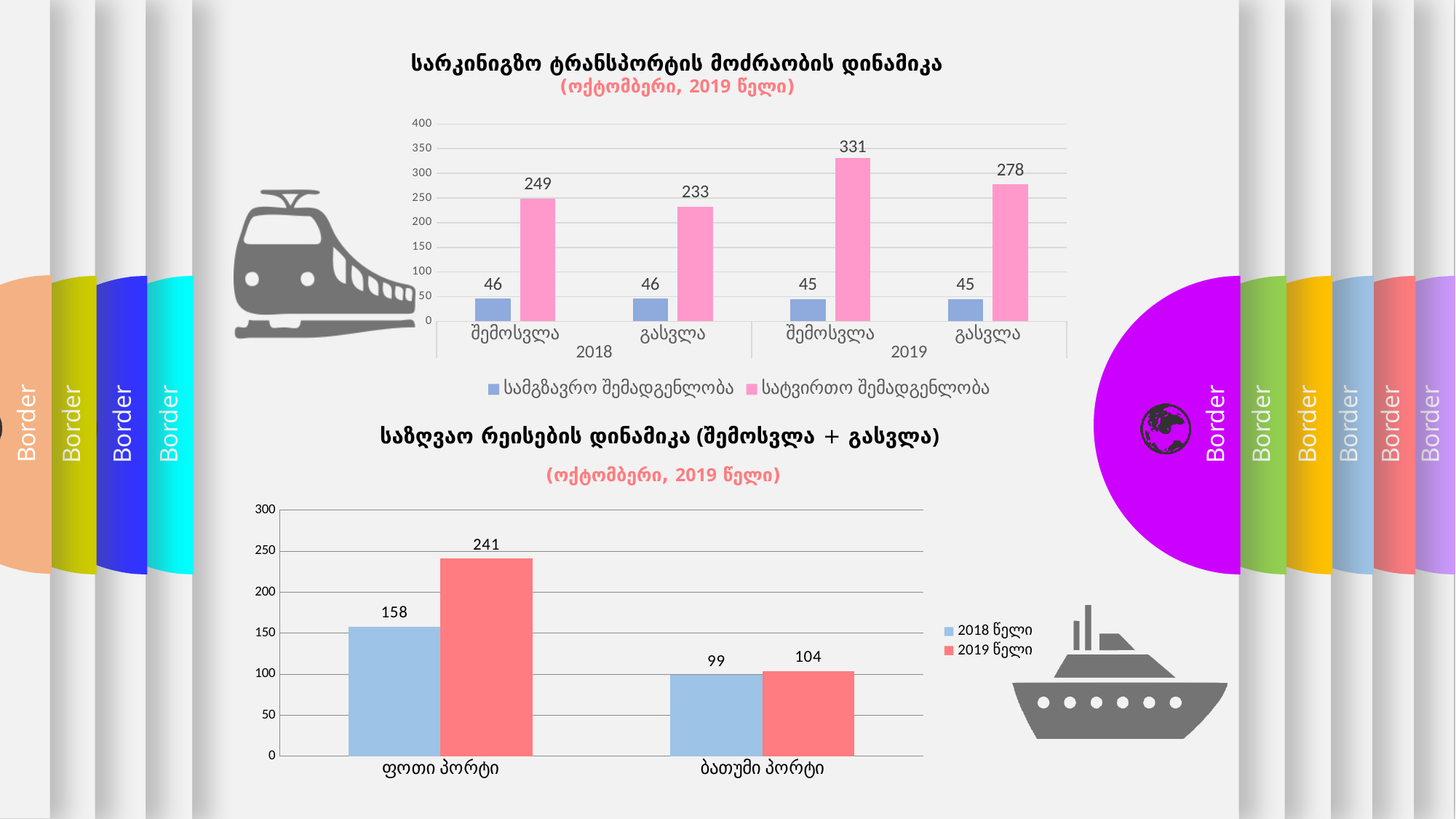
In the top chart, which category has the highest value for სატვირთო შემადგენლობა? შემოსვლა 2019 In the top chart, what is the value of სამგზავრო შემადგენლობა for გასვლა in 2018? 46 In the bottom chart, what is the value for ბათუმი პორტი in 2018 წელი? 99 In the bottom chart, which colour represents 2019 წელი? Red In the top chart, what is the difference between the სატვირთო შემადგენლობა values for შემოსვლა in 2019 and შემოსვლა in 2018? 82 What kind of chart is the top chart? Bar chart In the bottom chart, what is the value for ფოთი პორტი in 2019 წელი? 241 In the top chart, how many series does the legend list? 2 In the bottom chart, what is the difference between the 2019 წელი and 2018 წელი values for ფოთი პორტი? 83 In the bottom chart, how many categories are shown on the x axis? 2 In the bottom chart, which port has the larger value for 2019 წელი, ფოთი პორტი or ბათუმი პორტი? ფოთი პორტი In the top chart, what is the value of სატვირთო შემადგენლობა for შემოსვლა in 2019? 331